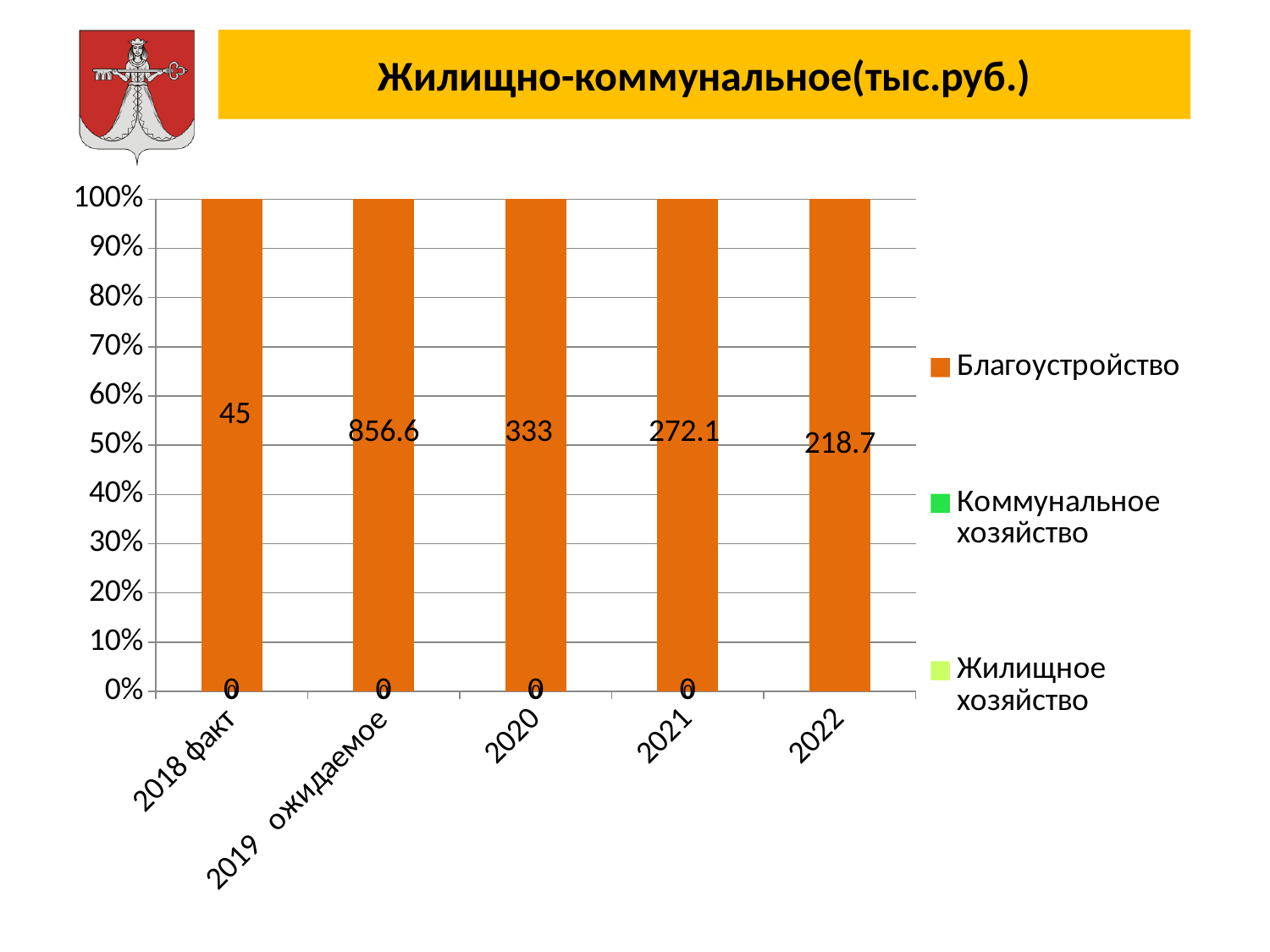
What is the value of Благоустройство for 2022? 218.7 What is the value of Благоустройство for 2018 факт? 45 Which category has the highest labelled value for Благоустройство? 2019 ожидаемое Which category has the lowest labelled value for Благоустройство? 2018 факт What is the value of Благоустройство for 2019 ожидаемое? 856.6 What is the value of Благоустройство for 2020? 333 What is the difference between the Благоустройство values for 2019 ожидаемое and 2020? 523.6 Which is larger, the Благоустройство value for 2020 or for 2021? 2020 What is the difference between the Благоустройство values for 2021 and 2022? 53.4 How many categories are shown on the x axis? 5 How many series does the legend list? 3 What kind of chart is shown on the slide? Bar chart